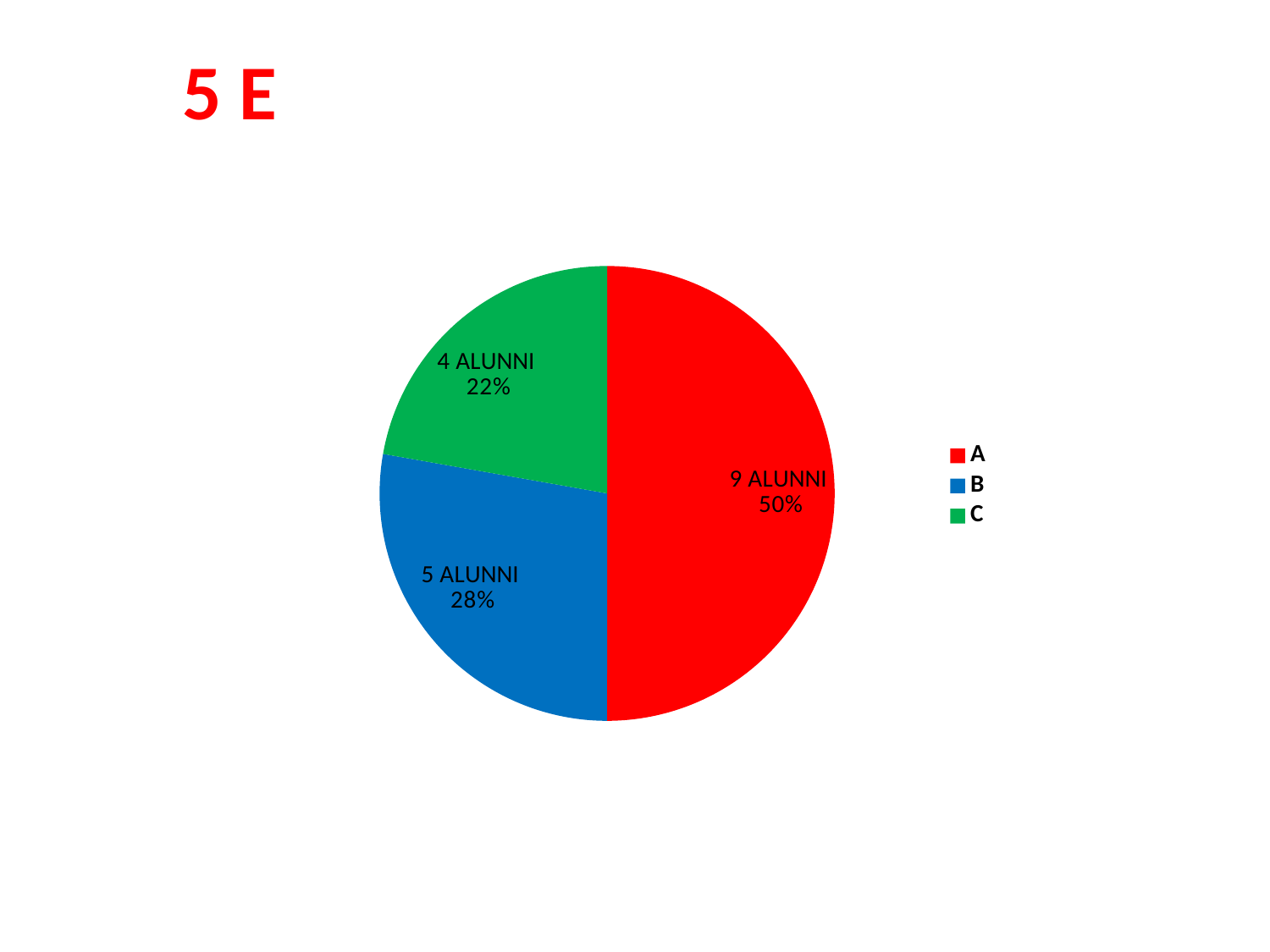
What share of the pie does category C represent? 22% What is the difference in number of alunni between category A and category B? 4 What kind of chart is shown on the slide? pie chart How many alunni are in category B? 5 ALUNNI Which category has the largest slice? A How many alunni are in category A? 9 ALUNNI Which colour represents category B in the pie chart? blue How many slices does the pie chart have? 3 Which category has the smallest slice? C How many alunni are in category C? 4 ALUNNI How many entries does the legend list? 3 What share of the pie does category A represent? 50%